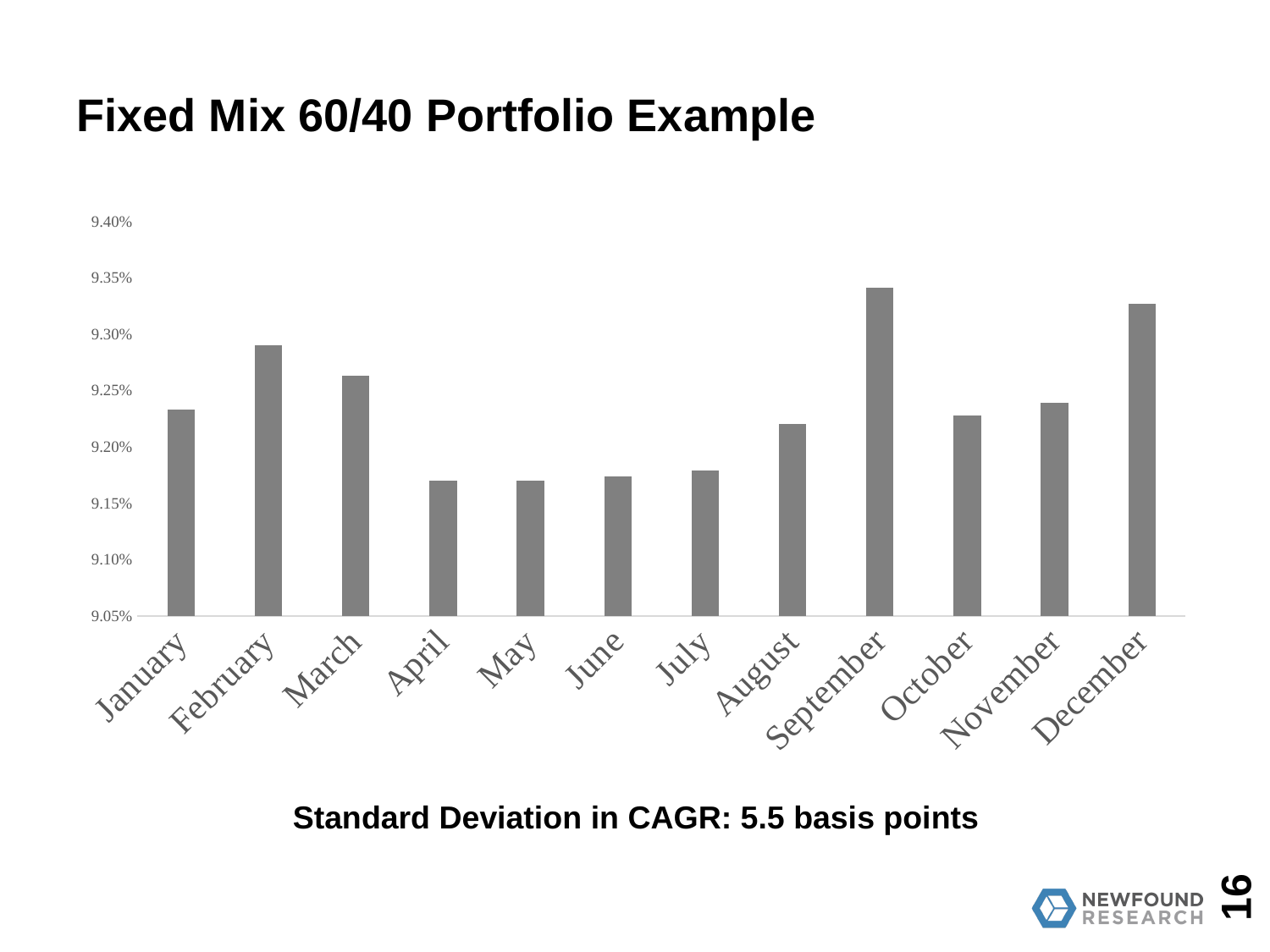
How many months are plotted on the x axis? 12 Is the value for August greater or less than 9.20%? greater Is the value for July greater or less than 9.20%? less Which is larger, the value for February or the value for March? February Is the value for February greater or less than 9.25%? greater What is the title of the slide containing the chart? Fixed Mix 60/40 Portfolio Example What kind of chart is shown on the slide? bar chart Which is larger, the value for September or the value for April? September Do the values rise or fall from April through September? rise